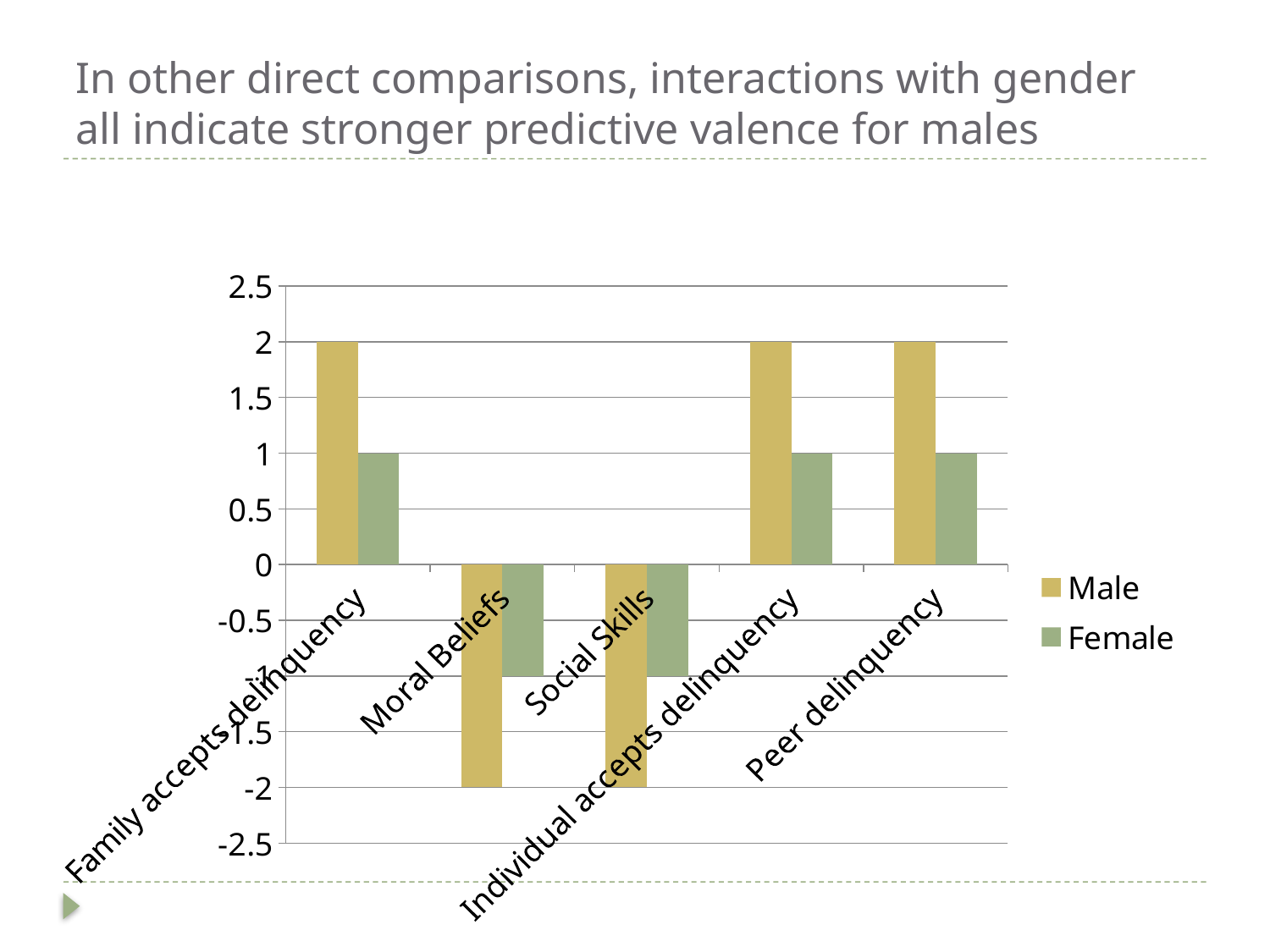
What is the difference between the Male and Female values for Individual accepts delinquency? 1 Is the Male value for Peer delinquency greater or less than 1.5? greater What are the two legend entries of the chart? Male and Female What is the Female value for Social Skills? -1 What is the Female value for Peer delinquency? 1 What is the Male value for Moral Beliefs? -2 How many series does the legend list? 2 Which series has the lowest value for Social Skills? Male What kind of chart is shown on the slide? bar chart How many categories are shown on the x axis? 5 Which is larger for Moral Beliefs, the Male value or the Female value? Female What is the Male value for Family accepts delinquency? 2